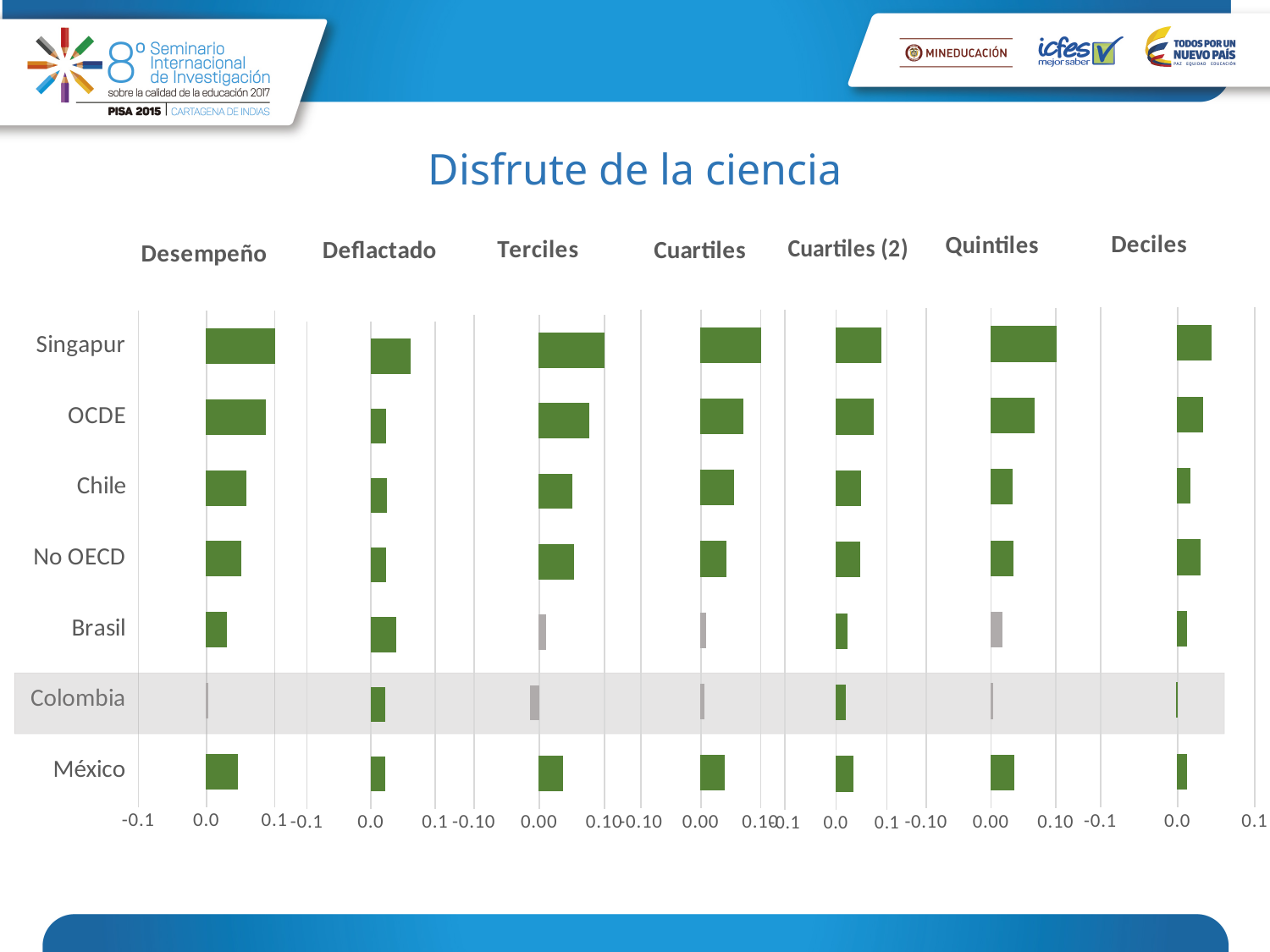
In the Desempeño chart, which category has the highest value? Singapur How many separate bar charts are shown on the slide? 7 In the Deflactado chart, which is larger, the value for Singapur or the value for Brasil? Singapur How many countries or groups are listed on the vertical axis of the Desempeño chart? 7 In the Cuartiles chart, which is larger, the value for Singapur or the value for México? Singapur What kind of chart is used for the Desempeño panel? bar chart In the Desempeño chart, which category has the lowest value? Colombia In the Desempeño chart, which is larger, the value for OCDE or the value for Chile? OCDE In the Desempeño chart, is the value for Singapur greater or less than 0.0? greater In the Quintiles chart, which category has the highest value? Singapur In the Terciles chart, which category has the highest value? Singapur What is the title of the slide above the charts? Disfrute de la ciencia